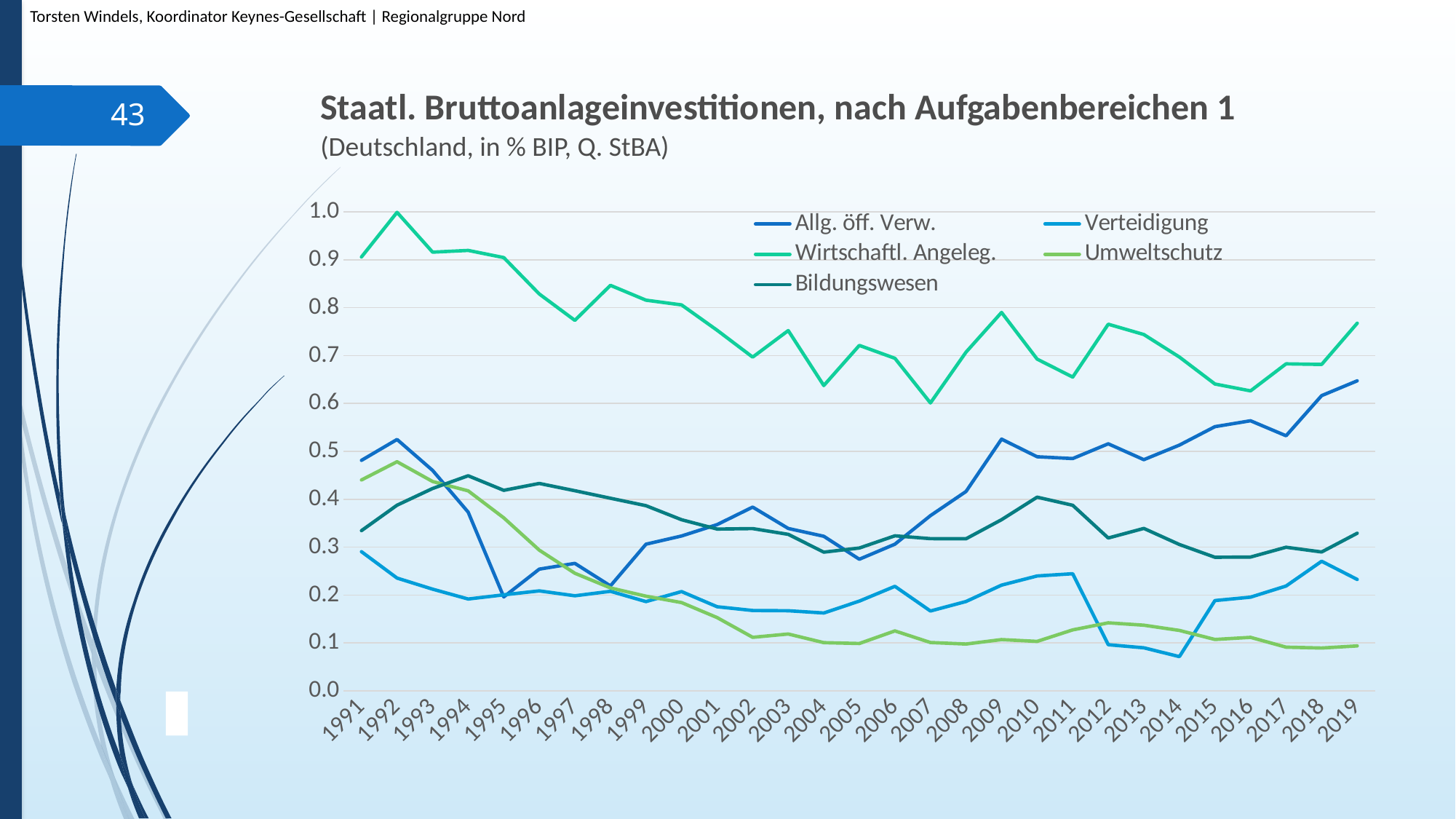
Which series has the lowest value in 2019? Umweltschutz Is the value for Allg. öff. Verw. in 2019 greater or less than 0.6? greater Is the value for Wirtschaftl. Angeleg. in 2007 greater or less than 0.7? less What is the title of the chart? Staatl. Bruttoanlageinvestitionen, nach Aufgabenbereichen 1 In 2019, which is larger: Allg. öff. Verw. or Bildungswesen? Allg. öff. Verw. Which series has the highest value in 1991? Wirtschaftl. Angeleg. What kind of chart is shown on the slide? Line chart What is the value for Wirtschaftl. Angeleg. in 1992? 1.0 How many series does the legend list? 5 Is the value for Verteidigung in 2014 greater or less than 0.1? less Does the Wirtschaftl. Angeleg. series overall rise or fall from 1991 to 2019? fall How many years are shown on the x axis? 29